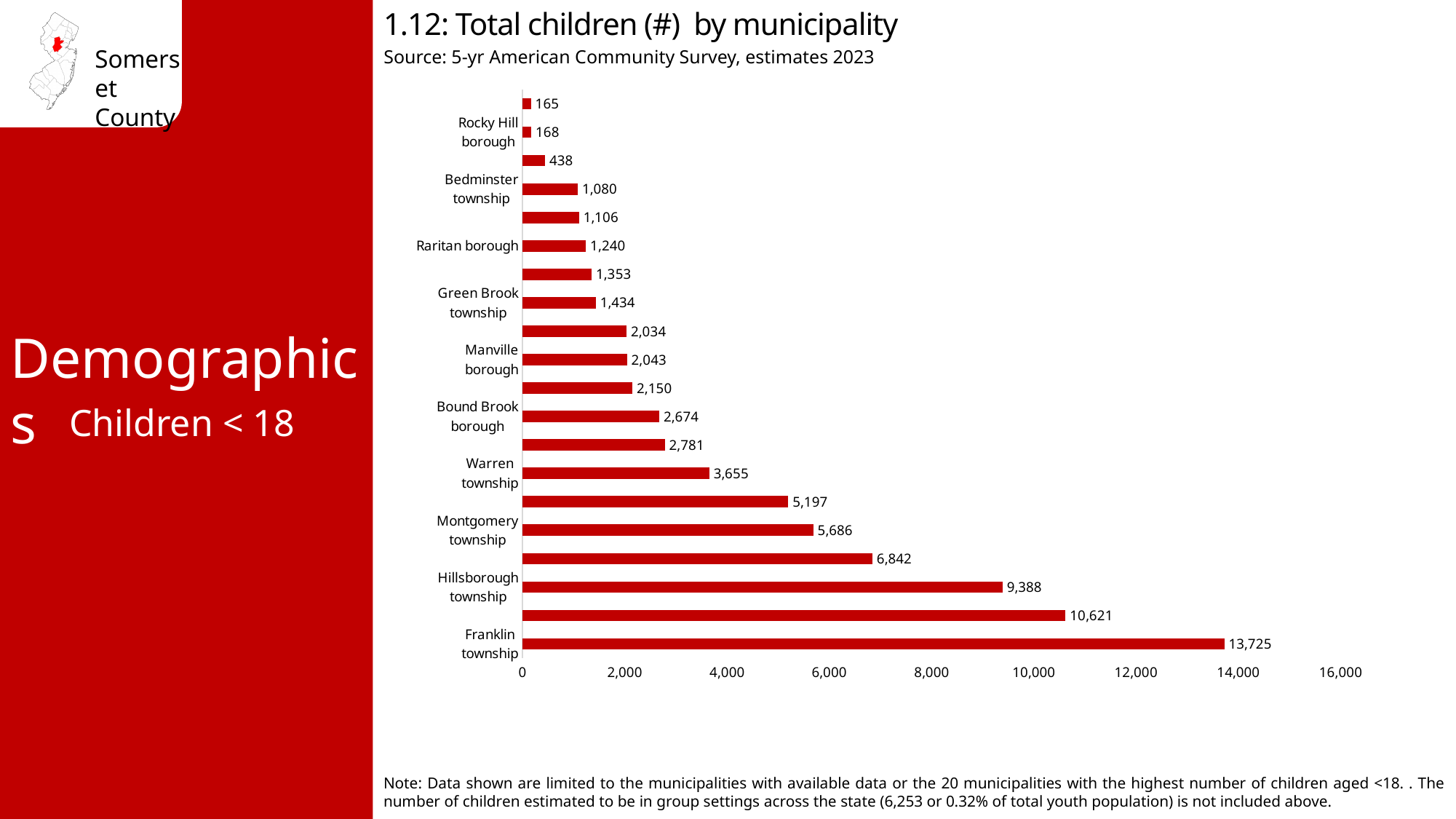
What is the total number of children for Montgomery township? 5,686 What is the source cited for the chart? 5-yr American Community Survey, estimates 2023 What is the smallest value shown on the chart? 165 What is the difference between the values for Franklin township and Hillsborough township? 4,337 Which municipality has the highest number of children? Franklin township What is the total number of children for Rocky Hill borough? 168 What is the total number of children for Hillsborough township? 9,388 Which has more children, Bound Brook borough or Manville borough? Bound Brook borough How many bars are plotted on the chart? 20 Is the value for Warren township greater or less than 4,000? less What is the total number of children for Franklin township? 13,725 What kind of chart is shown on the slide? bar chart